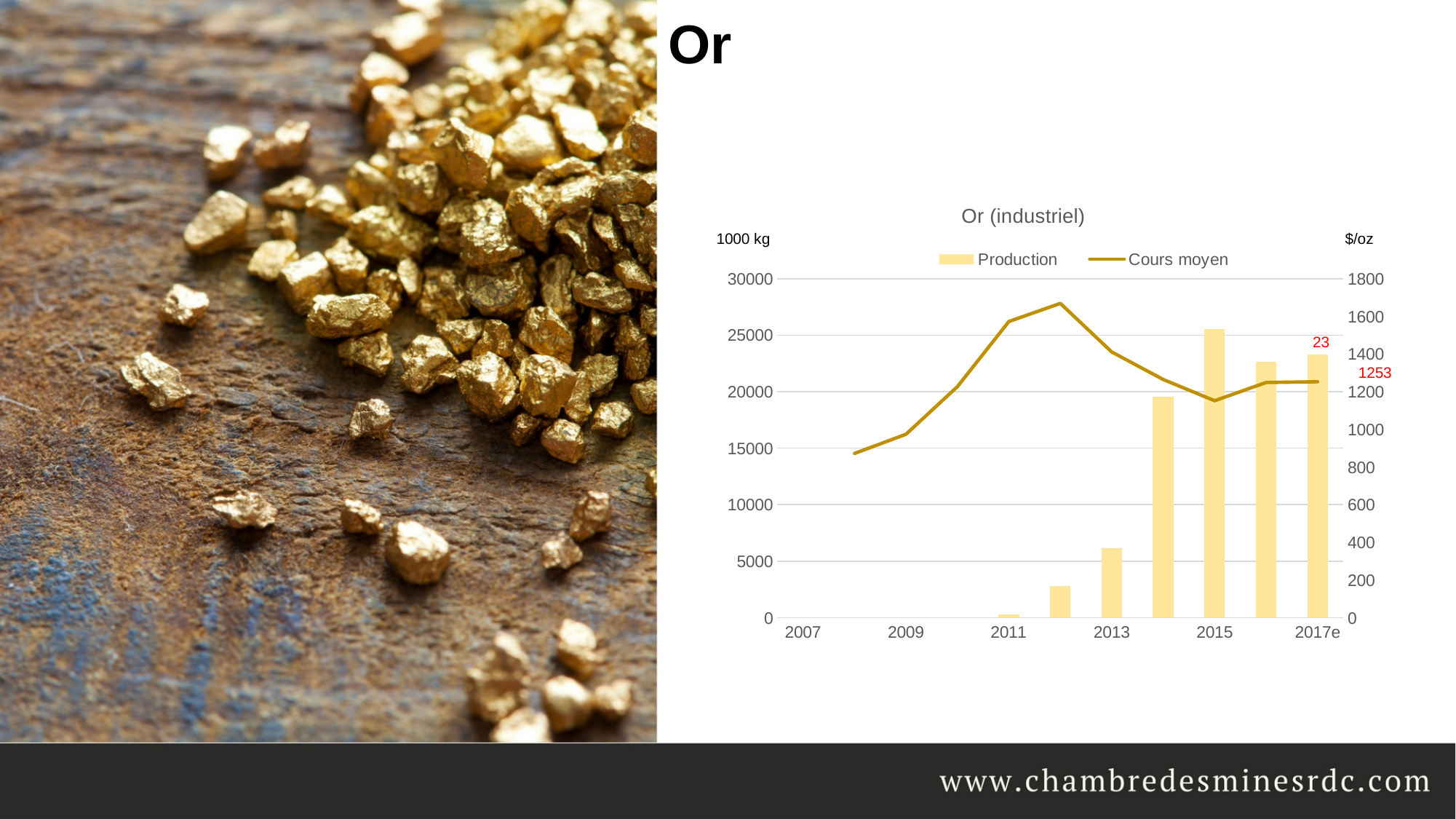
In which year is Production highest? 2015 Is the Cours moyen value for 2012 greater or less than 1600? greater How many series does the chart legend list? 2 What is the Production value labelled for 2017e? 23 In which year is Cours moyen at its lowest point? 2008 Which is larger, Production in 2015 or Production in 2016? 2015 What is the Cours moyen value labelled for 2017e? 1253 What kind of chart is shown on the slide? Combination bar and line chart What is the title of the chart? Or (industriel) Does Cours moyen rise or fall between 2012 and 2015? fall Is the Production value for 2013 greater or less than 10000? less In which year does Cours moyen reach its highest point? 2012